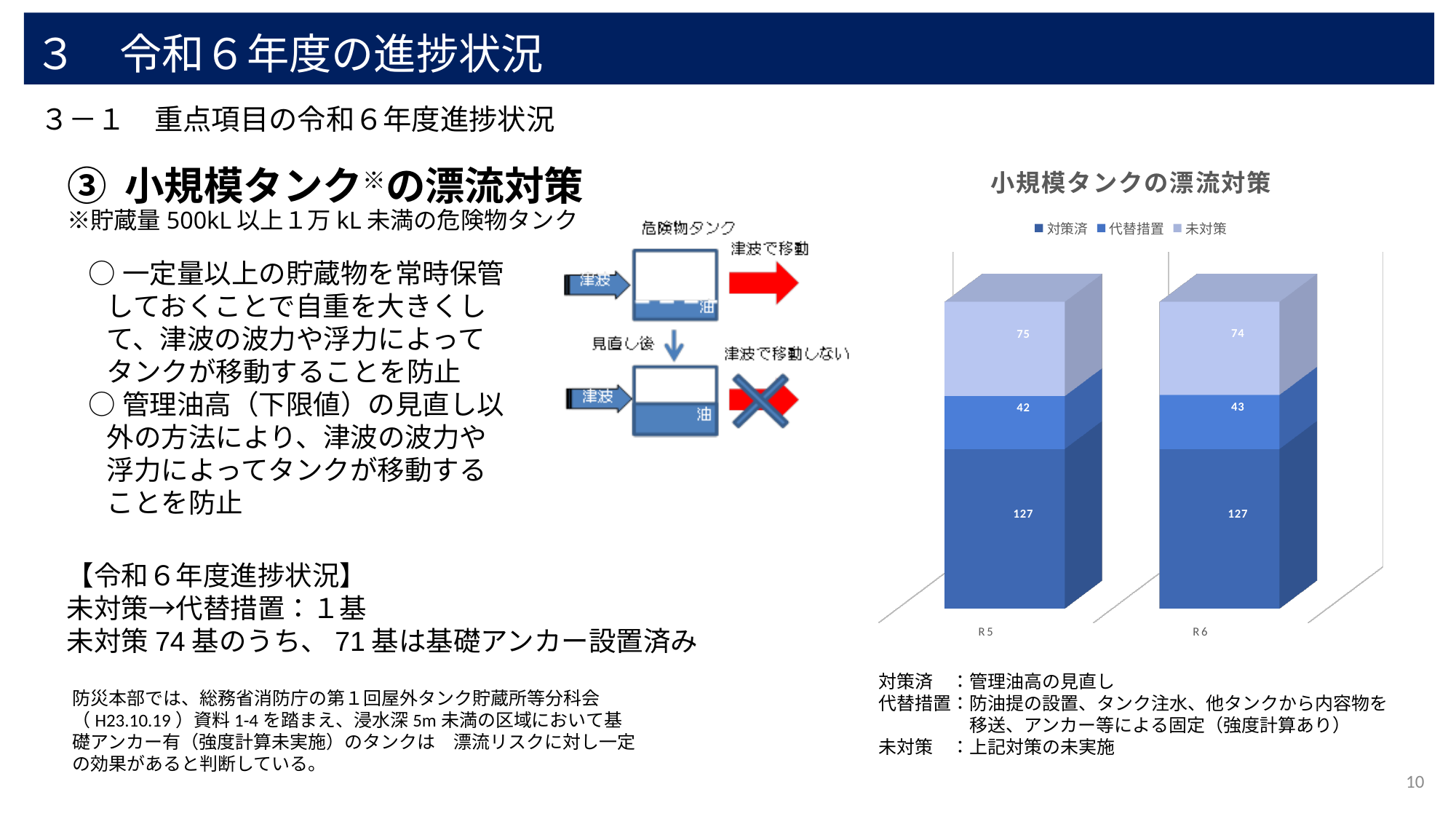
Which series has the largest value in the R6 bar? 対策済 What is the value of 未対策 for R5? 75 What is the value of 代替措置 for R6? 43 How many categories are shown on the x axis of the chart? 2 Is the 代替措置 value larger for R5 or for R6? R6 How many series does the chart's legend list? 3 What kind of chart is shown on the slide? stacked bar chart What is the total of the stacked bar for R5? 244 What is the difference between the 未対策 values for R5 and R6? 1 What is the title of the chart on the slide? 小規模タンクの漂流対策 What is the value of 対策済 for R6? 127 Which series has the smallest value in the R5 bar? 代替措置